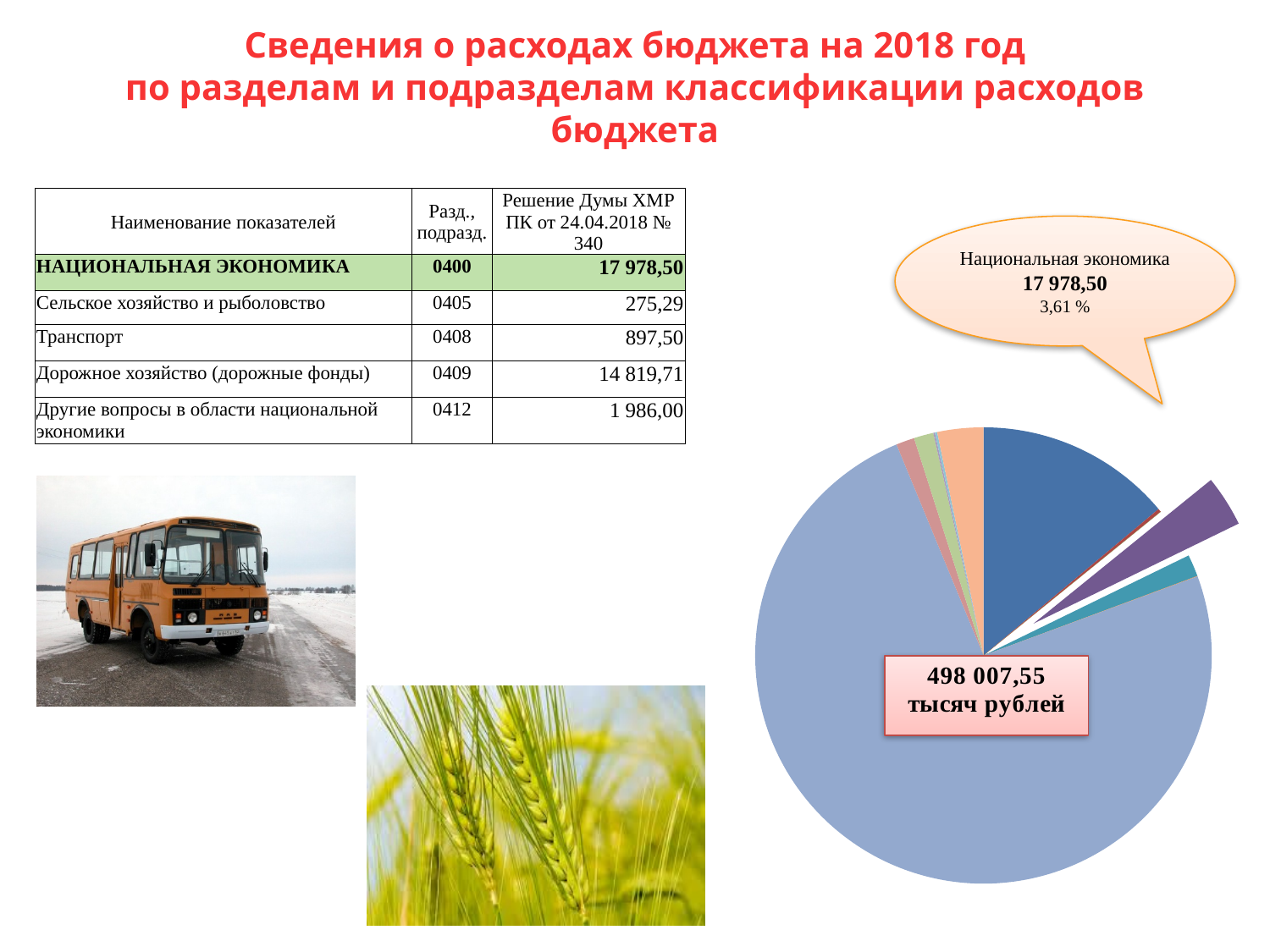
In the pie chart, what share of the total does Национальная экономика represent according to the callout? 3,61 % What colour is the largest slice of the pie chart? light blue (periwinkle) Does the pie chart have a legend? No What total amount is printed in the box on the pie chart? 498 007,55 тысяч рублей In the pie chart, is the Национальная экономика slice larger or smaller than the largest slice? smaller In the pie chart, what value is given in the callout for Национальная экономика? 17 978,50 What kind of chart is shown on the right side of the slide? pie chart